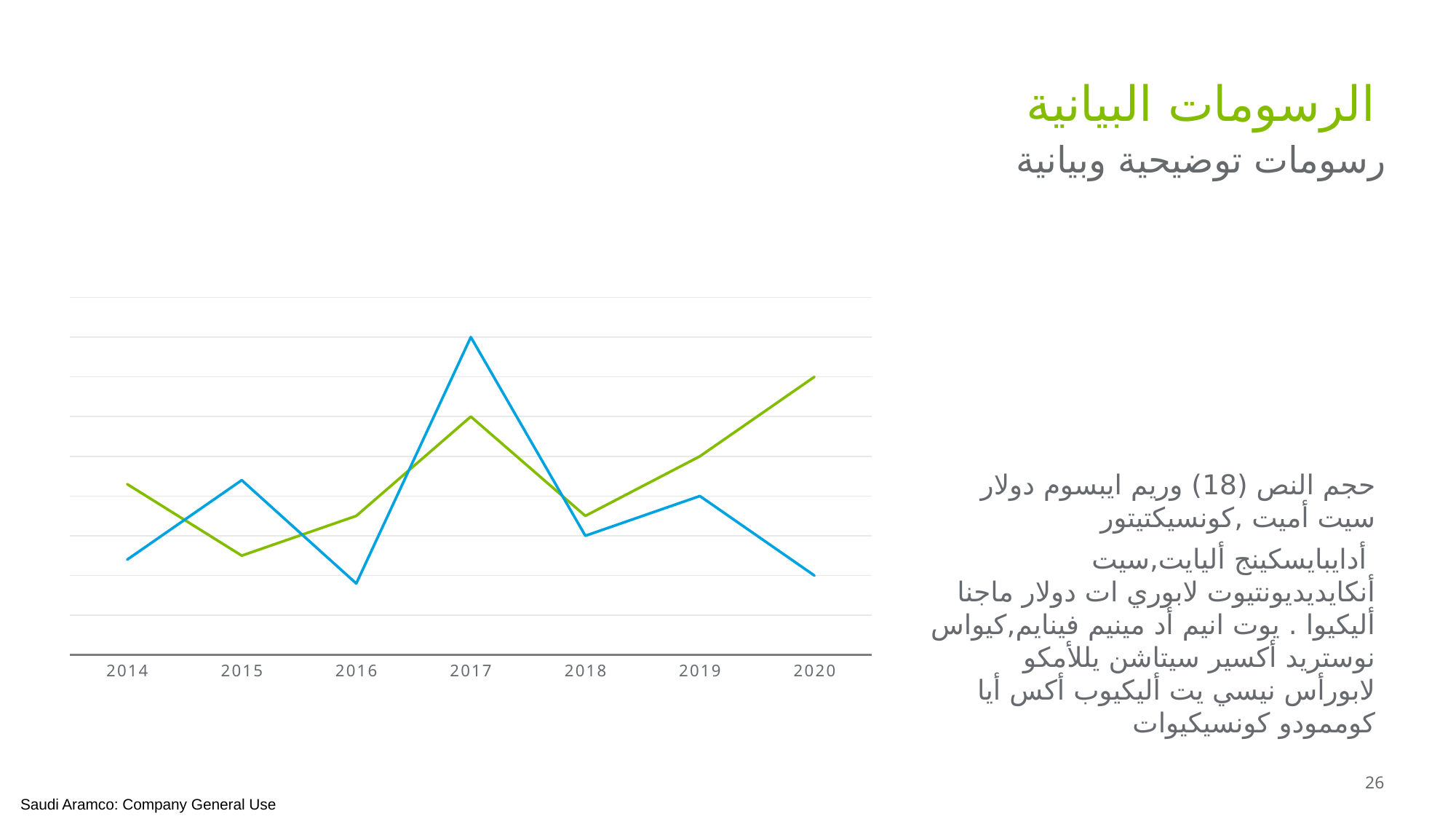
How many years are shown on the x axis of the chart? 7 What kind of chart is shown on the slide? line chart How many lines are plotted on the chart? 2 In which year does the blue line reach its lowest point? 2016 Does the green line rise or fall from 2018 to 2020? rise In 2015, which line is higher, the blue line or the green line? blue In which year does the green line reach its highest point? 2020 In which year does the blue line reach its highest point? 2017 In 2020, which line is higher, the blue line or the green line? green In which year does the green line reach its lowest point? 2015 In 2017, which line is higher, the blue line or the green line? blue Does the blue line rise or fall from 2019 to 2020? fall